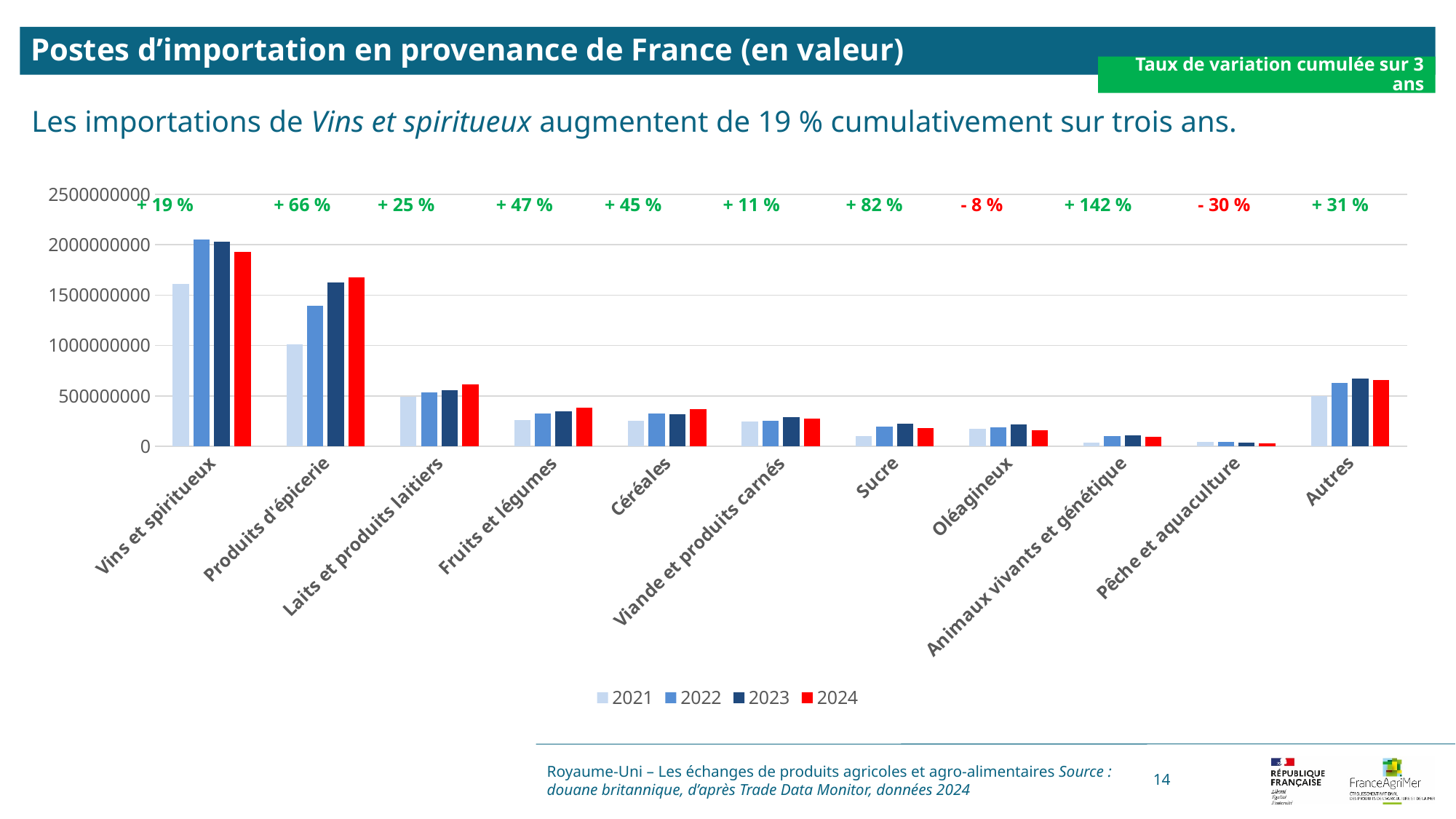
How many series does the chart legend list? 4 How many product categories are shown on the x axis of the chart? 11 Which category has the lowest import values in the chart? Pêche et aquaculture Is the 2021 value for Vins et spiritueux greater or less than 1500000000? greater Is the 2021 value for Produits d'épicerie greater or less than 1500000000? less What kind of chart is shown on the slide? Bar chart Which category has the highest import values in the chart? Vins et spiritueux Which category shows the highest cumulative 3-year variation rate? Animaux vivants et génétique What is the cumulative 3-year variation rate printed above Pêche et aquaculture? - 30 % Which is larger for Vins et spiritueux: the 2022 value or the 2024 value? 2022 What is the cumulative 3-year variation rate printed above Produits d'épicerie? + 66 % Do the values for Produits d'épicerie rise or fall from 2021 to 2024? Rise